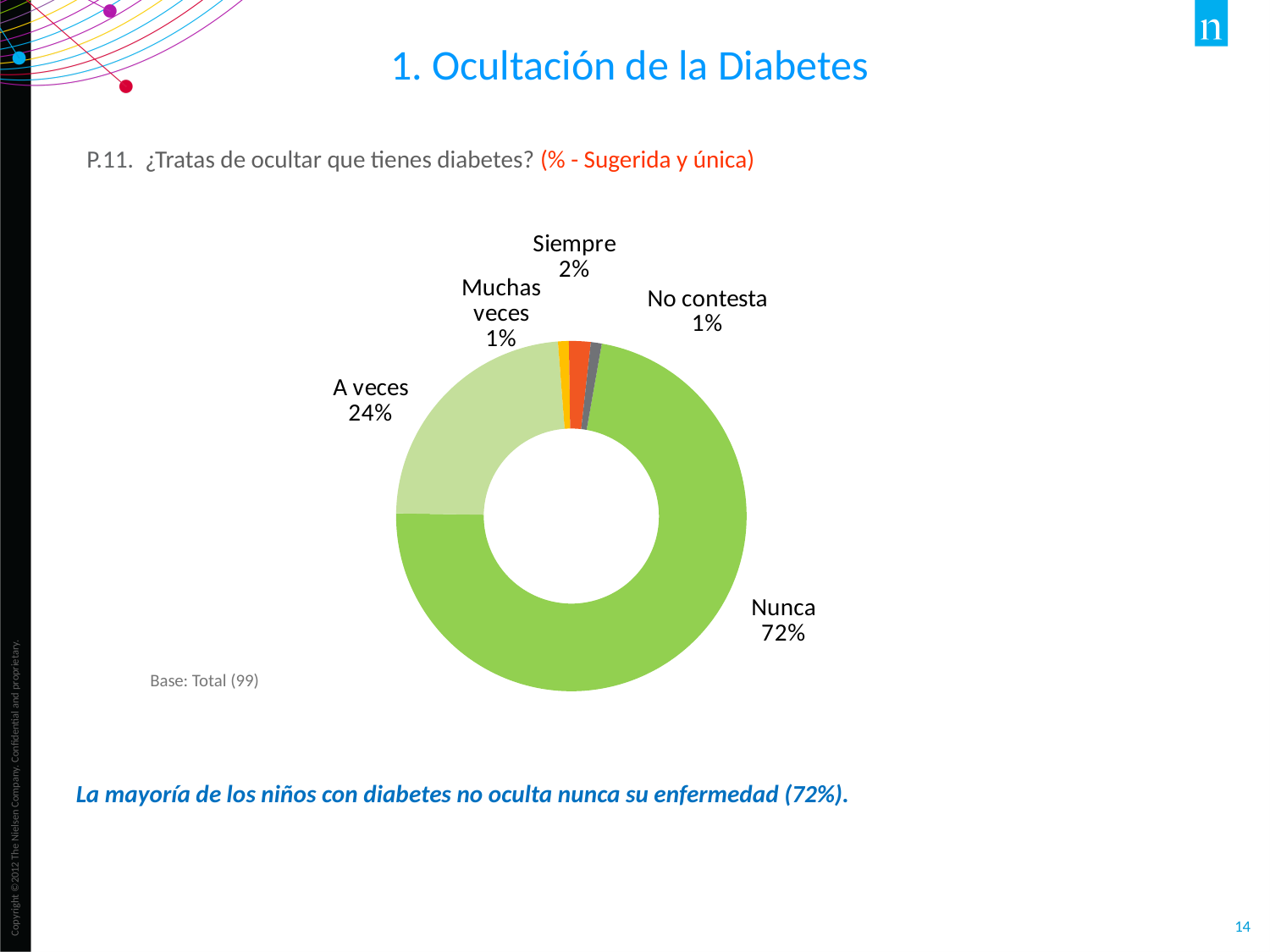
What is the combined share of "Nunca" and "A veces"? 96% Which category has the largest share of the chart? Nunca What is the difference in percentage points between "Nunca" and "A veces"? 48 What percentage of respondents did not answer ("No contesta")? 1% What percentage of respondents answered "Muchas veces"? 1% What percentage of respondents answered "A veces"? 24% What percentage of respondents answered "Siempre"? 2% Which is larger, the share for "Siempre" or the share for "Muchas veces"? Siempre What is the base (number of respondents) stated for the chart? Total (99) What kind of chart is shown on the slide? Doughnut (pie) chart How many categories are shown in the chart? 5 What percentage of respondents answered "Nunca"? 72%